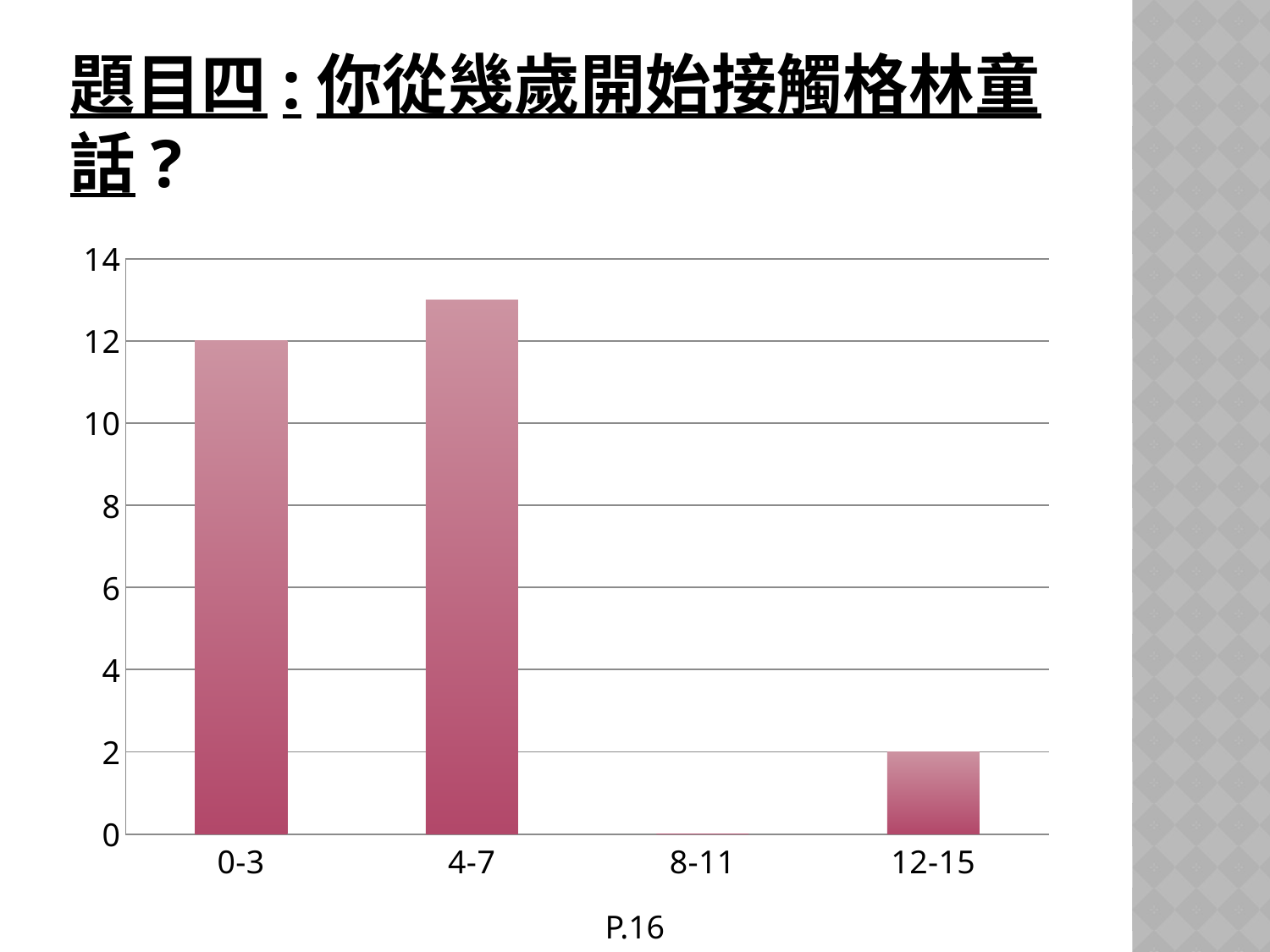
Is the value for 12-15 greater or less than 4? less What is the highest value shown on the vertical axis? 14 Which category has the lowest value? 8-11 Which category has the highest value? 4-7 What is the value for the 12-15 category? 2 What is the value for the 0-3 category? 12 How many categories are shown on the x axis? 4 What text appears directly below the x axis of the chart? P.16 Is the value for 4-7 greater or less than 12? greater What is the difference between the values for 0-3 and 12-15? 10 Which is larger, the value for 0-3 or the value for 12-15? 0-3 What kind of chart is shown on the slide? bar chart